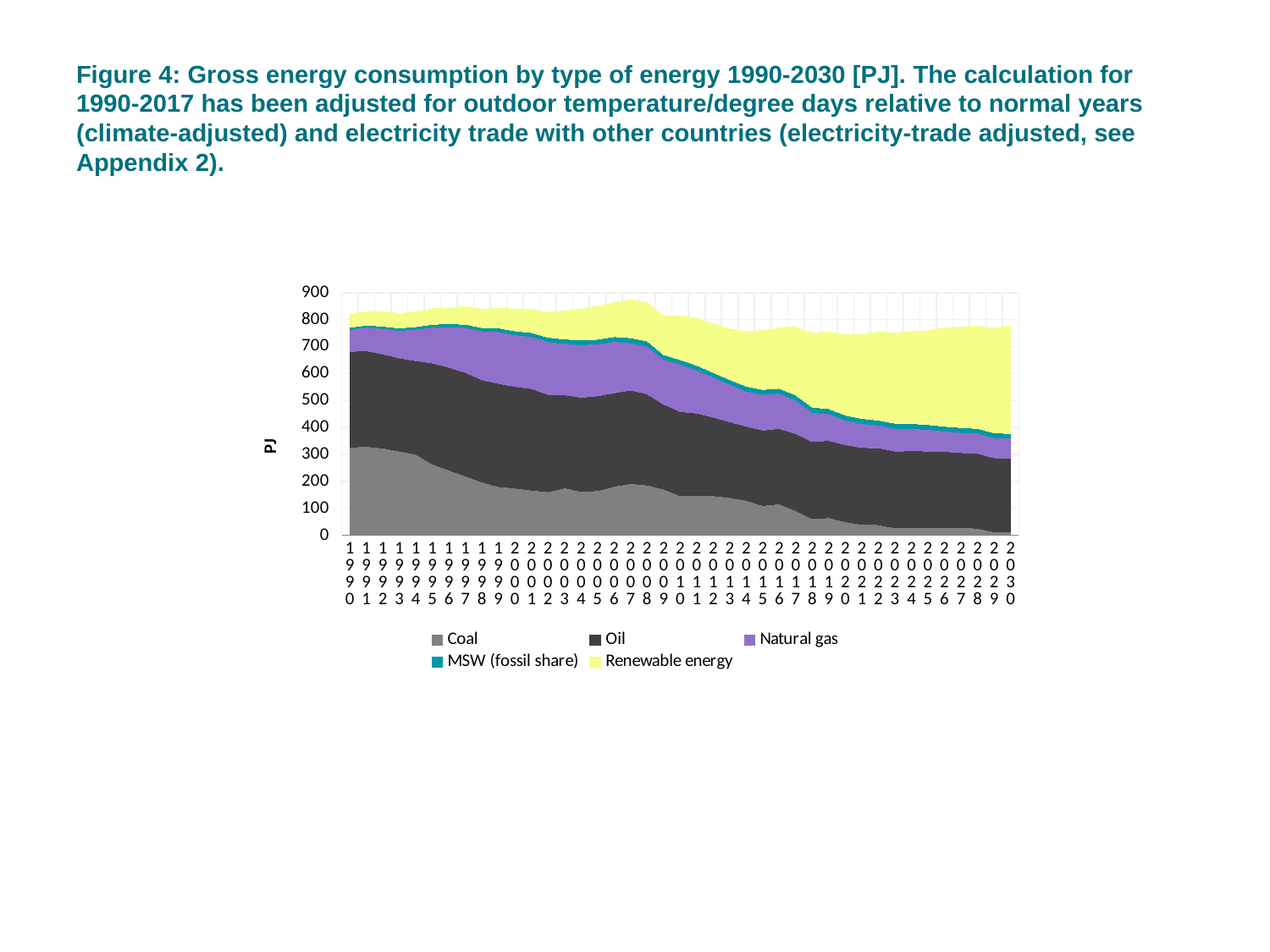
In 1990, which is larger: Coal or Renewable energy? Coal Is the value for Coal in 2030 greater or less than 100? less Is the total gross energy consumption in 1990 greater or less than 800? greater What is the label on the y axis? PJ Is the total gross energy consumption in 2030 greater or less than 800? less Which series accounts for the largest share of consumption in 2030? Renewable energy What kind of chart is shown on the slide? Stacked area chart Which series is shown in yellow in the legend? Renewable energy How many series does the legend list? 5 How many years are plotted along the x axis? 41 Does the Coal area rise or fall from 1990 to 2030? Fall